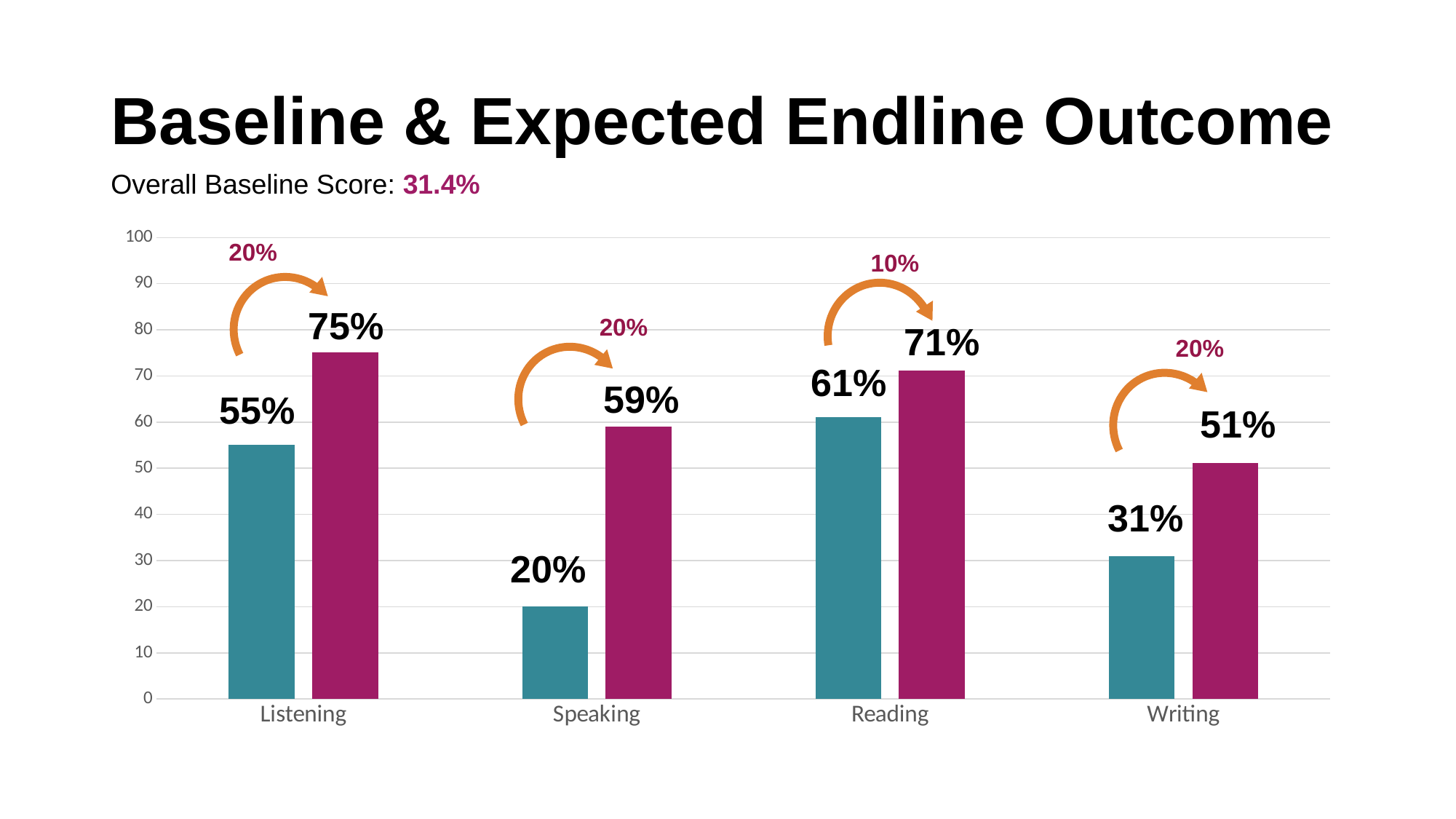
Which category has the highest magenta bar? Listening Which is larger: the teal bar for Reading or the magenta bar for Writing? The teal bar for Reading Which category has the highest teal bar? Reading What Overall Baseline Score is stated on the slide? 31.4% What is the difference between the magenta bar and the teal bar for Speaking? 39% What is the value of the teal bar for Writing? 31% What is the value of the magenta bar for Speaking? 59% What is the value of the teal bar for Listening? 55% What kind of chart is shown on the slide? Bar chart What is the value of the magenta bar for Reading? 71% How many categories are shown on the x axis? 4 Which category has the lowest teal bar? Speaking